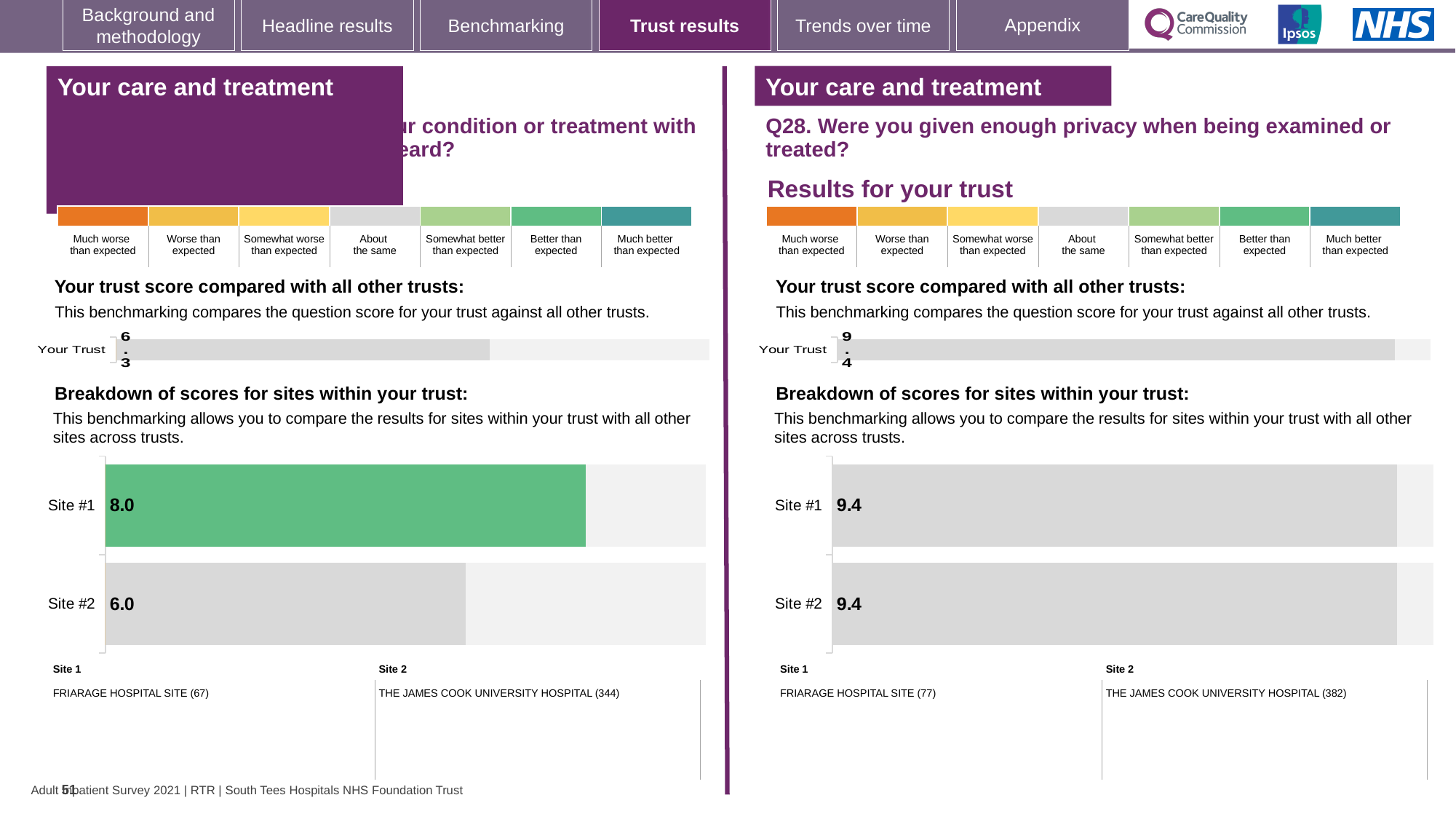
In the left-hand 'Your trust score compared with all other trusts' chart, what is the score for Your Trust? 6.3 In the left-hand site breakdown chart, is the score for Site #1 larger or smaller than the score for Site #2? larger In the Q28 'Breakdown of scores for sites within your trust' chart on the right, what is the score for Site #2? 9.4 In the left-hand site breakdown chart, which site has the higher score? Site #1 What kind of chart is the left-hand 'Breakdown of scores for sites within your trust' chart? bar chart In the left-hand site breakdown chart, what colour is the bar for Site #1? green In the left-hand site breakdown chart, what is the difference between the scores for Site #1 and Site #2? 2.0 In the left-hand 'Breakdown of scores for sites within your trust' chart, what is the score for Site #2? 6.0 In the Q28 'Your trust score compared with all other trusts' chart on the right, what is the score for Your Trust? 9.4 How many sites are shown in the Q28 site breakdown chart on the right? 2 In the Q28 'Breakdown of scores for sites within your trust' chart on the right, what is the score for Site #1? 9.4 In the left-hand 'Breakdown of scores for sites within your trust' chart, what is the score for Site #1? 8.0